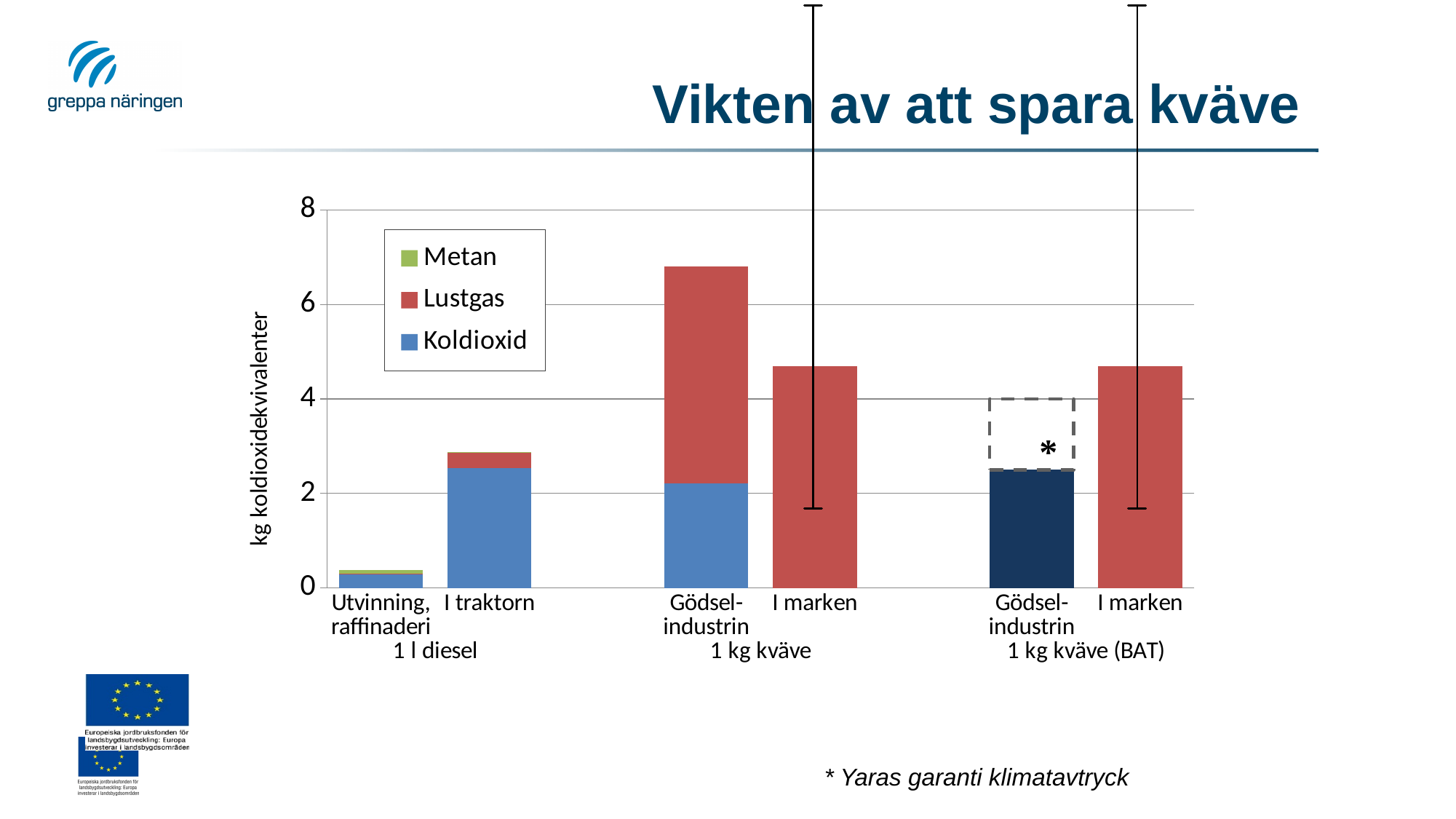
Which bar is the tallest in the chart? Gödselindustrin (1 kg kväve) Is the value for I marken under 1 kg kväve greater or less than 4? greater What is the title of the chart's vertical axis? kg koldioxidekvivalenter Is the total value for I traktorn greater or less than 2? greater Which legend entry is shown in red? Lustgas How many bars are plotted in the chart? 6 How many series does the chart legend list? 3 Which is larger, the bar for I traktorn or the bar for I marken under 1 kg kväve? I marken Is the value for Utvinning, raffinaderi greater or less than 2? less Which bar is the shortest in the chart? Utvinning, raffinaderi What kind of chart is shown on the slide? Stacked bar chart